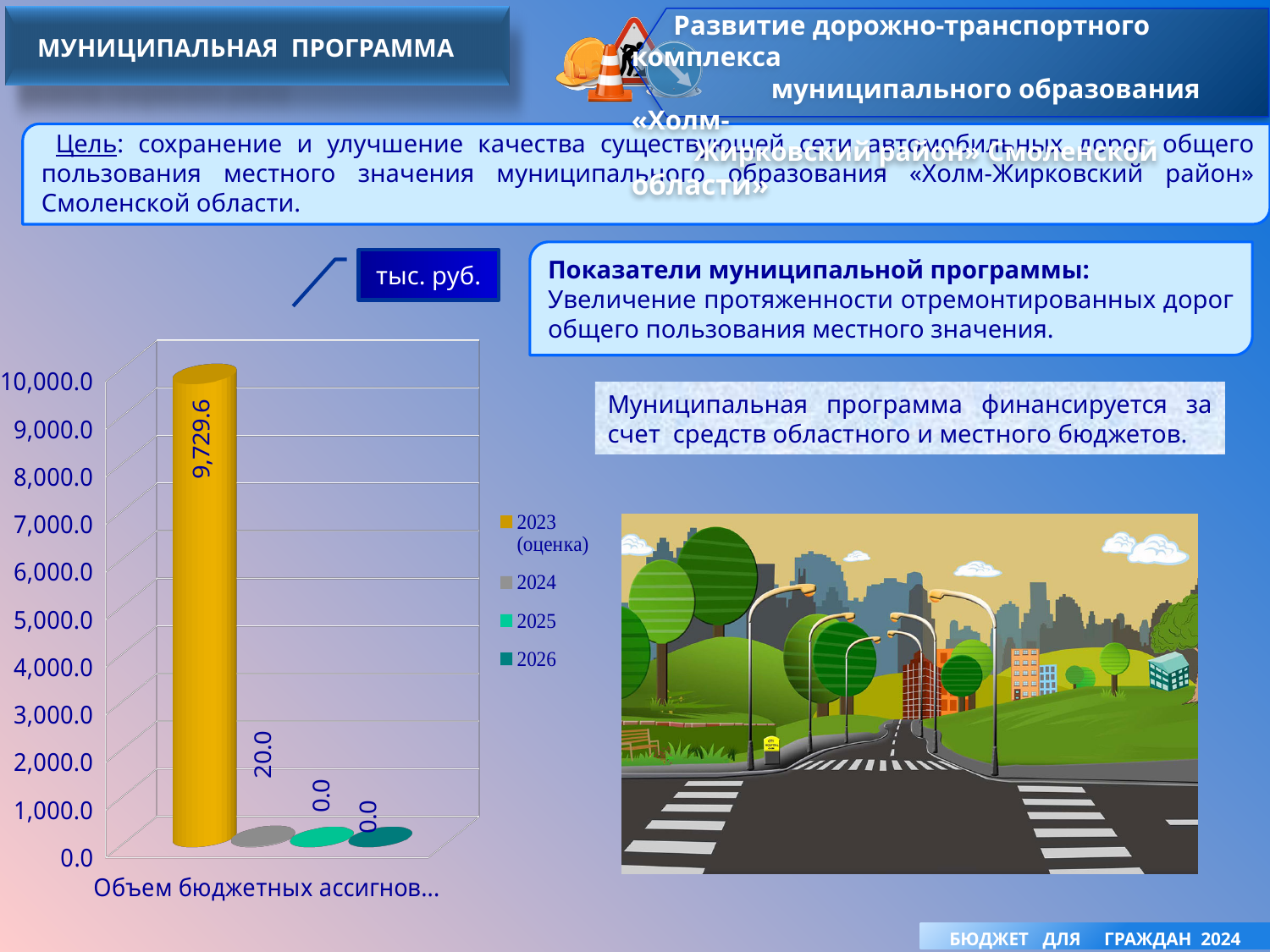
Which is larger, the value for 2024 or the value for 2025? 2024 What is the difference between the values for 2023 (оценка) and 2024? 9,709.6 What is the value for 2025 in the chart? 0.0 What is the value for 2023 (оценка) in the chart? 9,729.6 How many series does the chart legend list? 4 What is the value for 2024 in the chart? 20.0 What is the value for 2026 in the chart? 0.0 Which series has the highest value in the chart? 2023 (оценка) What colour is the bar for 2023 (оценка) in the chart? yellow What unit of measurement is indicated for the chart values? тыс. руб. Is the value for 2023 (оценка) greater or less than 9,000.0? greater What kind of chart is shown on the slide? bar chart